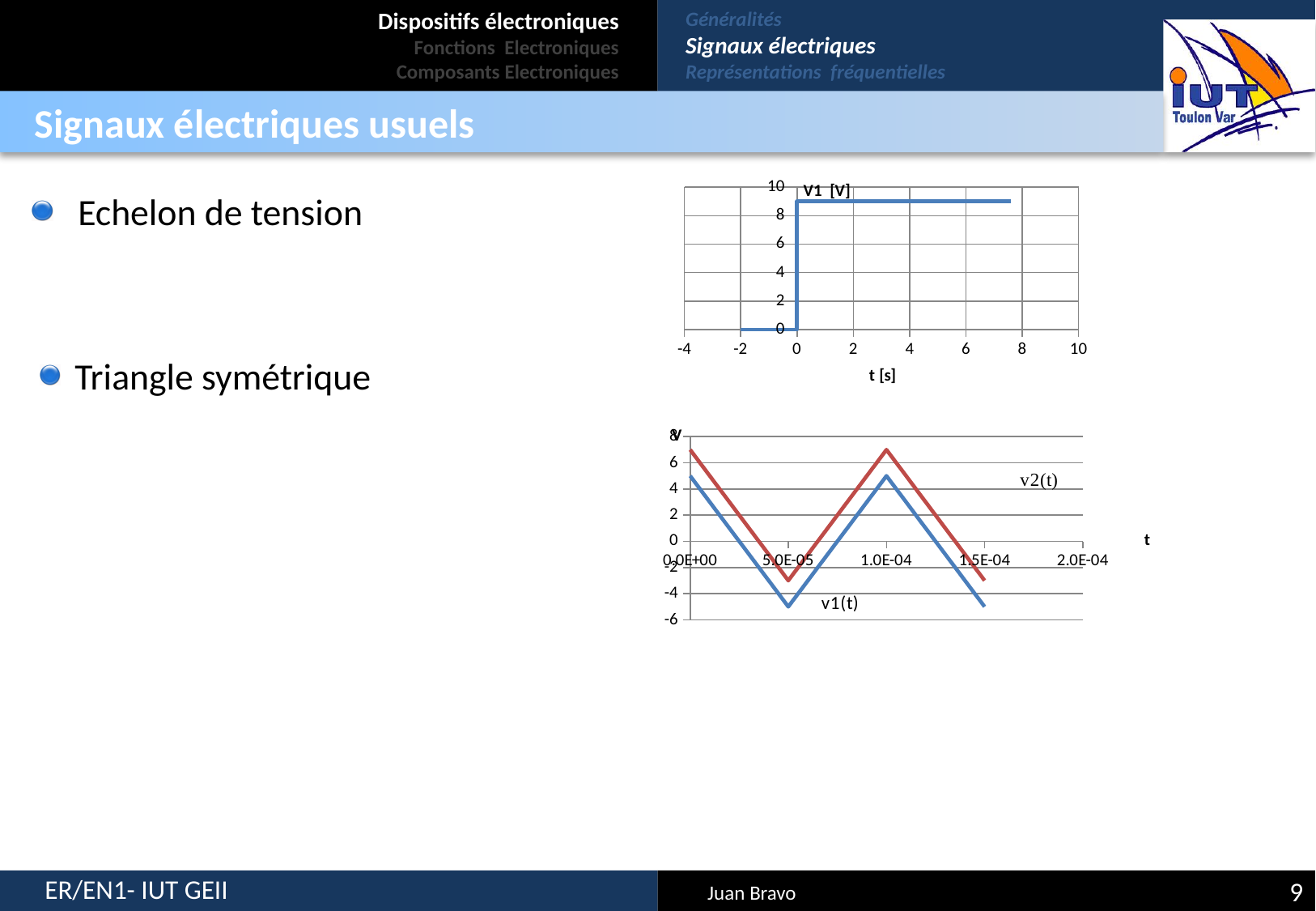
What kind of chart is the top chart titled V1 [V]? line chart In the top chart V1 [V], is the value of V1 for t greater than 0 greater or less than 8? greater In the bottom chart, is the peak value of v2(t) greater or less than 6? greater What kind of chart is the bottom chart showing v1(t) and v2(t)? line chart In the bottom chart, which signal reaches the higher peak value, v1(t) or v2(t)? v2(t) How many signals are plotted in the bottom chart? 2 In the bottom chart, does v1(t) rise or fall between t = 0.0E+00 and t = 5.0E-05? fall In the top chart V1 [V], what is the value of V1 for t less than 0? 0 In the top chart V1 [V], is the value of V1 for t greater than 0 greater or less than 10? less In the bottom chart, which signal reaches the lower minimum value, v1(t) or v2(t)? v1(t) In the top chart V1 [V], at what value of t does the signal step up? 0 In the top chart V1 [V], what is the label of the horizontal axis? t [s]